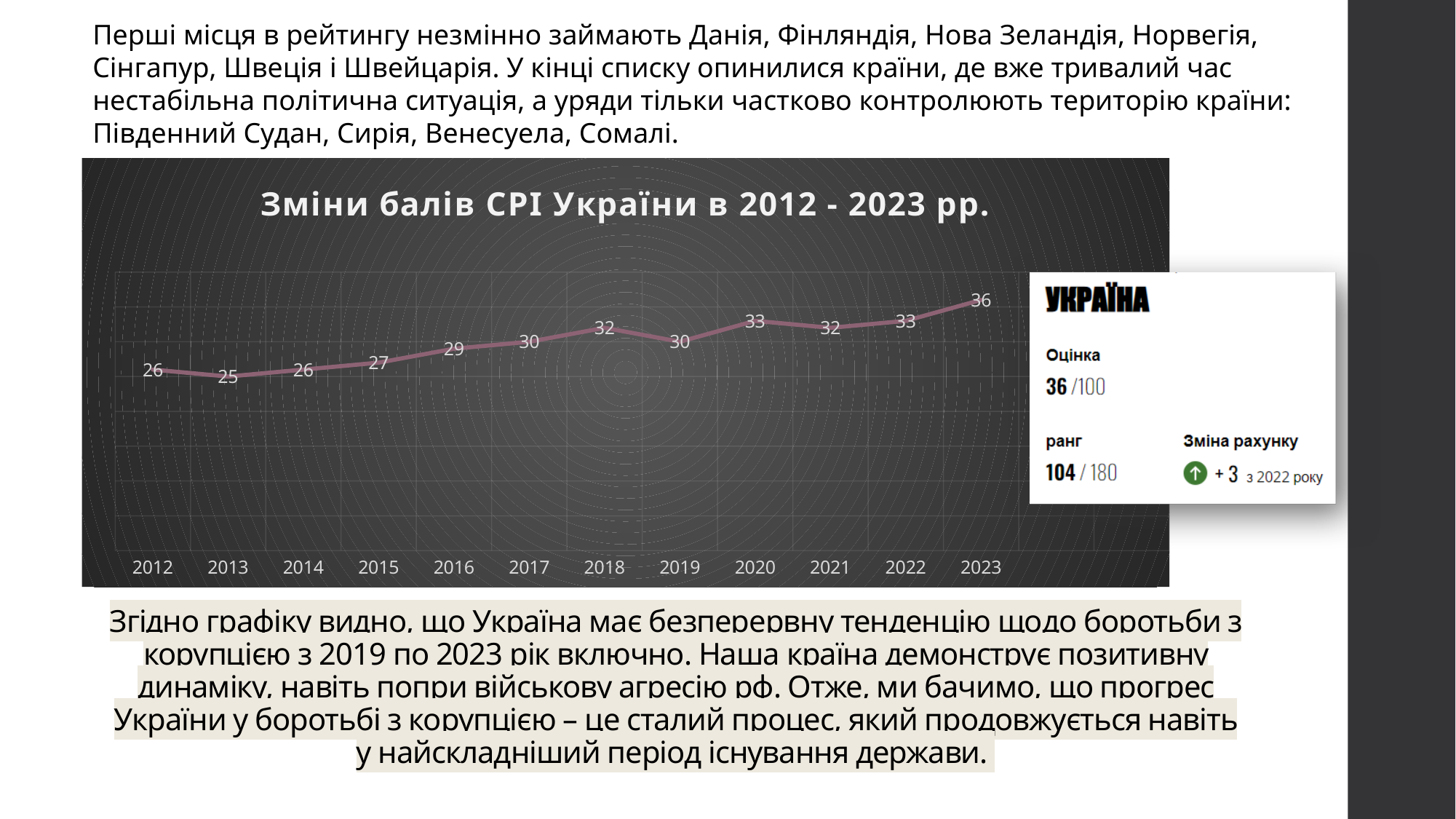
How many years (data points) are plotted on the chart? 12 What is the CPI score for Ukraine in 2023 according to the chart? 36 What kind of chart is shown on the slide? Line chart What is the CPI score for Ukraine in 2018? 32 Which year has the lowest CPI score on the chart? 2013 What is the CPI score for Ukraine in 2013? 25 What is the title of the chart? Зміни балів CPI України в 2012 - 2023 рр. What is the difference between the CPI scores for 2023 and 2012? 10 Which year has a higher CPI score, 2018 or 2019? 2018 What is the difference between the CPI scores for 2022 and 2023? 3 Which year has the highest CPI score on the chart? 2023 Do the CPI scores generally rise or fall from 2012 to 2023? Rise